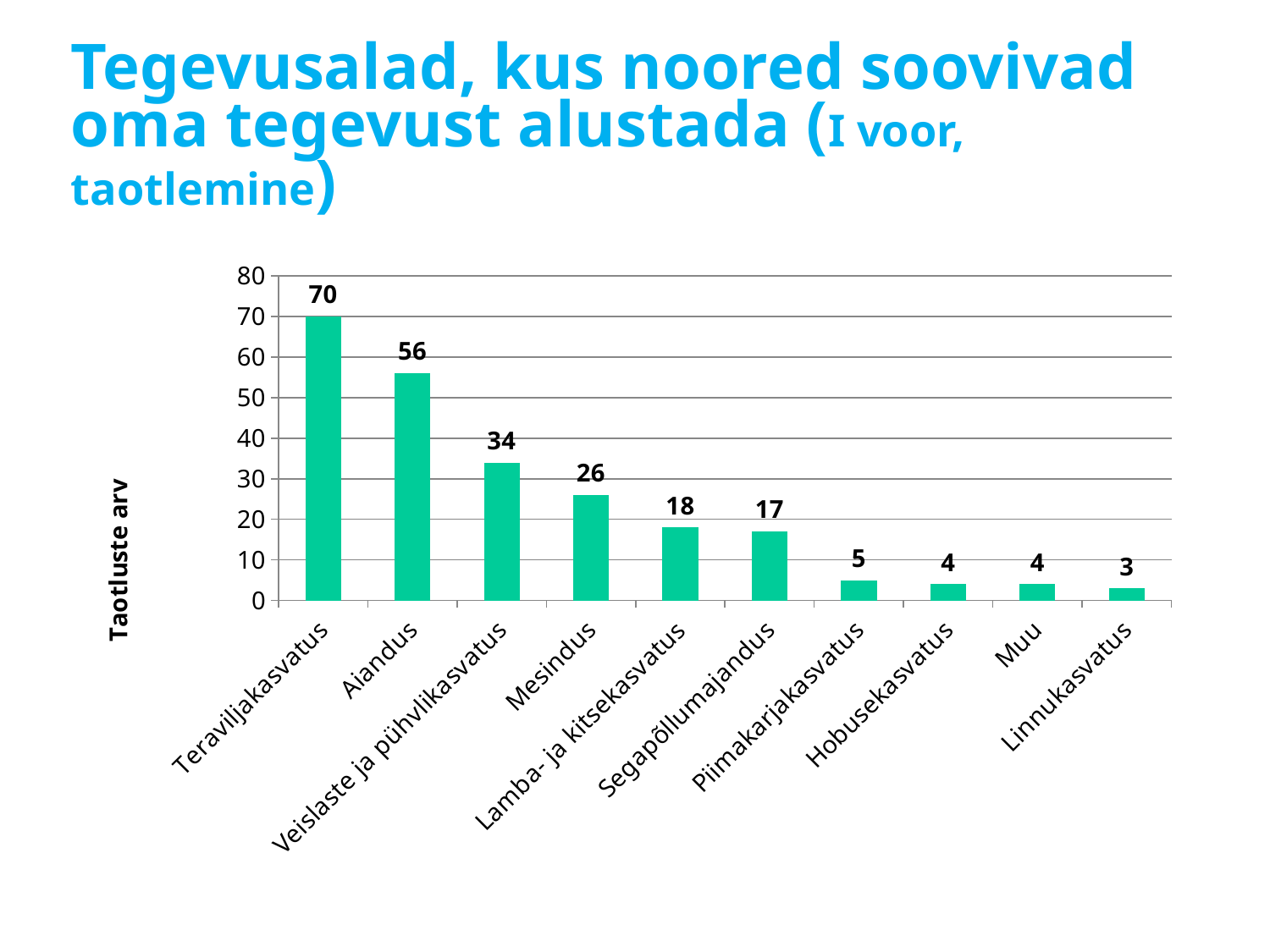
What is the difference between the values for Teraviljakasvatus and Aiandus? 14 What is the value for Teraviljakasvatus? 70 What is the difference between the values for Veislaste ja pühvlikasvatus and Mesindus? 8 Is the value for Lamba- ja kitsekasvatus greater or less than 20? less How many categories are shown on the x axis? 10 What kind of chart is shown on the slide? bar chart What is the label of the vertical axis? Taotluste arv Which category has the highest value? Teraviljakasvatus What is the value for Mesindus? 26 Which is larger, the value for Aiandus or the value for Veislaste ja pühvlikasvatus? Aiandus What is the value for Segapõllumajandus? 17 Which category has the lowest value? Linnukasvatus